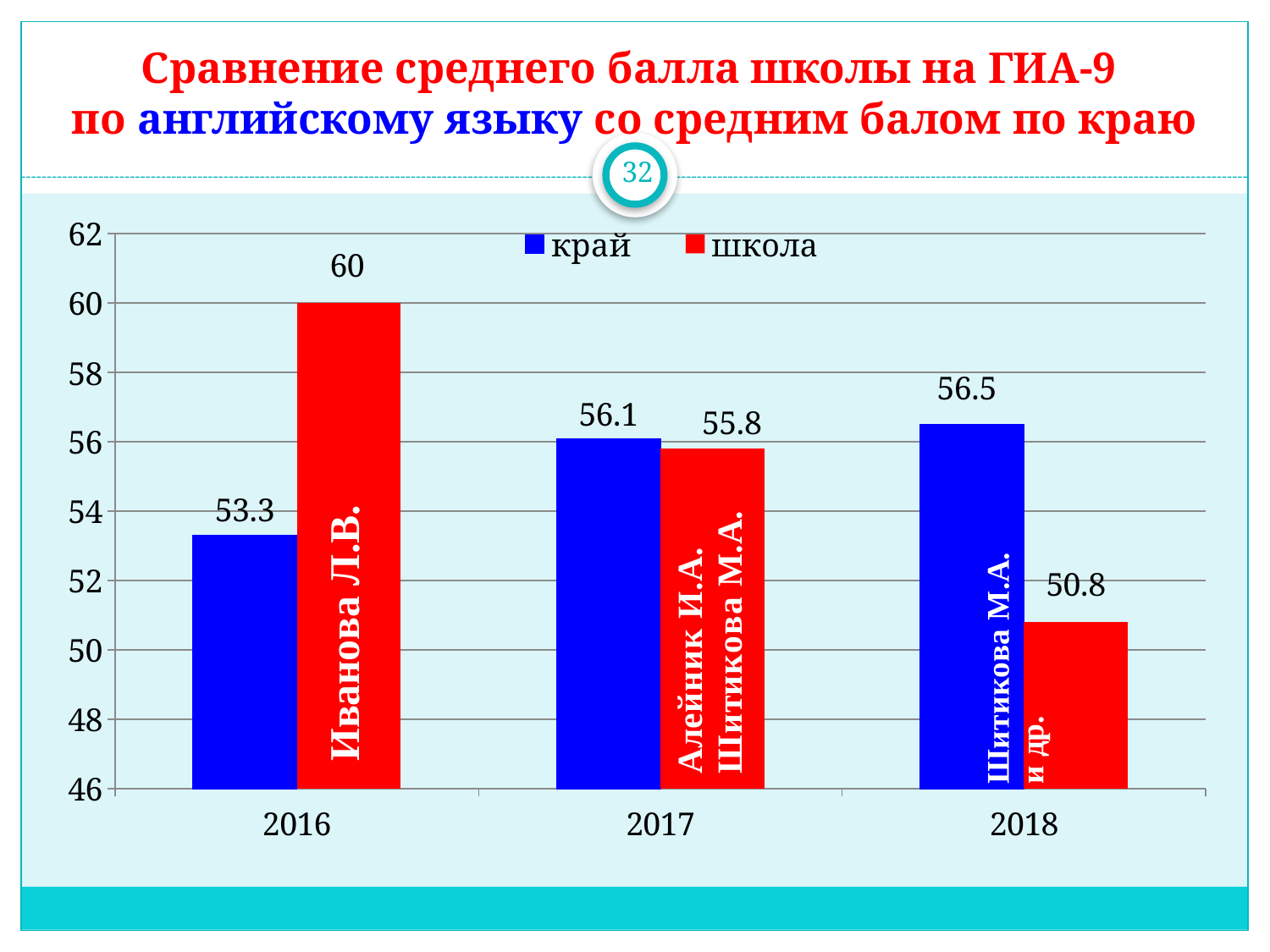
What is the value for край in 2017? 56.1 In which year is the школа value lowest? 2018 In which year is the школа value highest? 2016 How many series does the legend list? 2 What is the value for школа in 2016? 60 What is the difference between the школа and край values in 2016? 6.7 What kind of chart is shown on the slide? bar chart What is the value for школа in 2018? 50.8 Does the край value rise or fall from 2016 to 2018? rise What is the value for край in 2016? 53.3 How many years are shown on the x axis? 3 Which is larger in 2018, край or школа? край